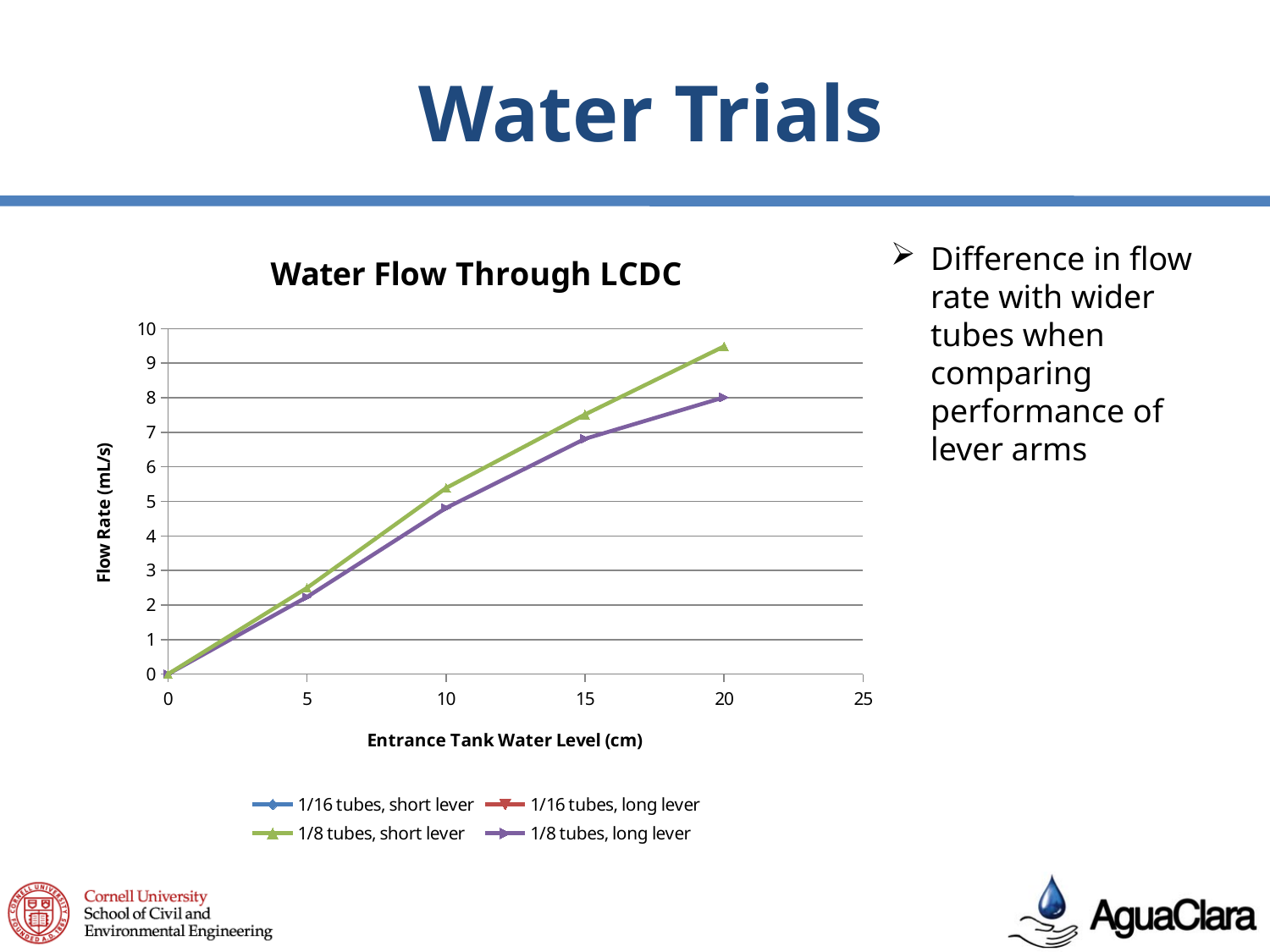
What is the flow rate for the 1/8 tubes, short lever series at an entrance tank water level of 0 cm? 0 How many series does the legend list? 4 Does the flow rate for 1/8 tubes, short lever rise or fall as the entrance tank water level increases? rise At 20 cm, which series has the higher flow rate: 1/8 tubes, short lever or 1/8 tubes, long lever? 1/8 tubes, short lever What is the title of the chart? Water Flow Through LCDC Is the flow rate for 1/8 tubes, long lever at 20 cm greater or less than 9? less What kind of chart is shown on the slide? line chart Is the flow rate for 1/8 tubes, short lever at 5 cm greater or less than 3? less How many data points are plotted for the 1/8 tubes, short lever series? 5 Is the flow rate for 1/8 tubes, long lever at 10 cm greater or less than 4? greater What is the label of the vertical axis? Flow Rate (mL/s)